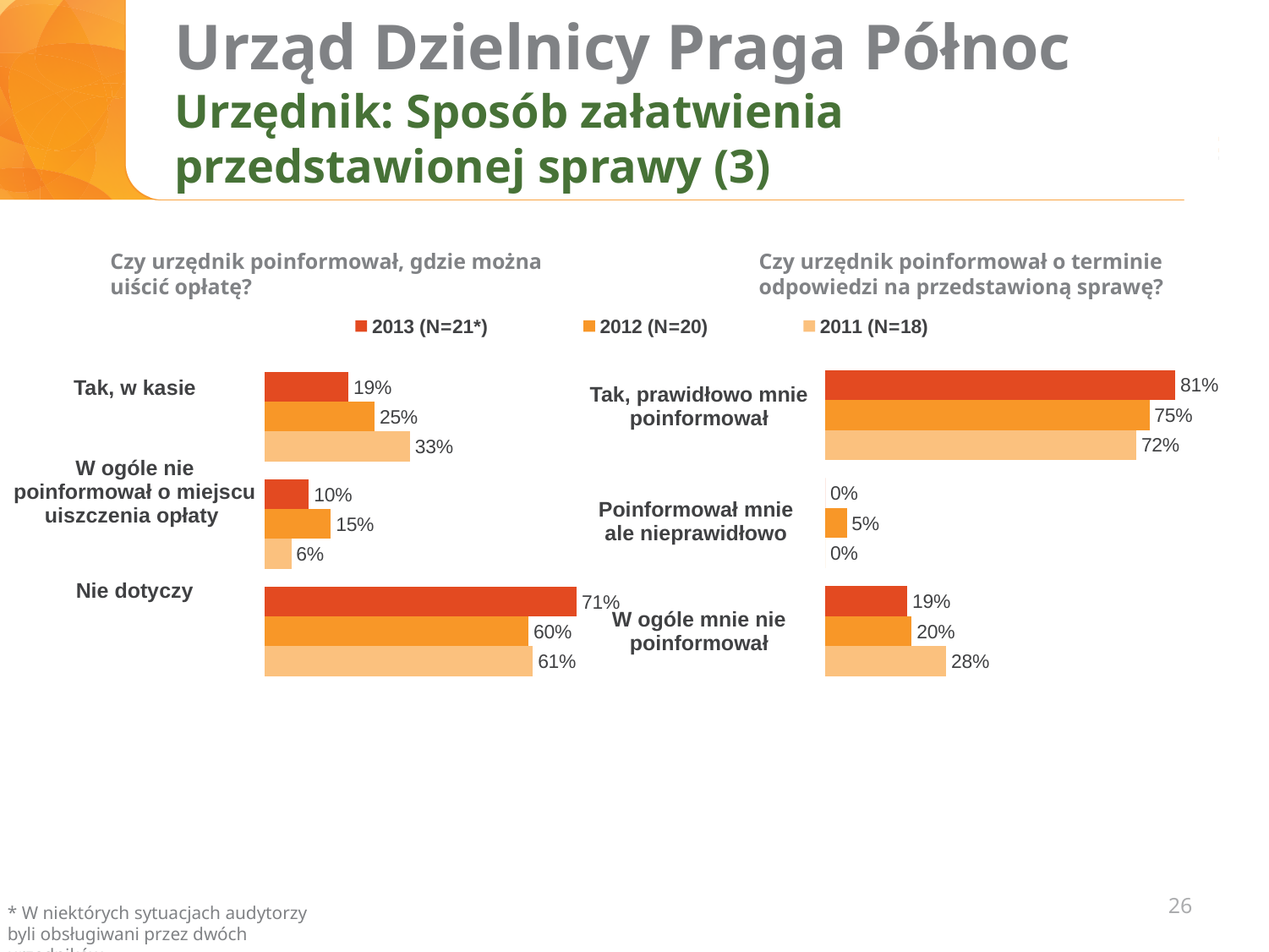
In the right chart ("Czy urzędnik poinformował o terminie odpowiedzi na przedstawioną sprawę?"), what is the value for "Poinformował mnie ale nieprawidłowo" in 2012 (N=20)? 5% What kind of chart is the left chart ("Czy urzędnik poinformował, gdzie można uiścić opłatę?")? Bar chart In the right chart ("Czy urzędnik poinformował o terminie odpowiedzi na przedstawioną sprawę?"), which category has the lowest value for 2011 (N=18)? Poinformował mnie ale nieprawidłowo In the right chart ("Czy urzędnik poinformował o terminie odpowiedzi na przedstawioną sprawę?"), what is the value for "Tak, prawidłowo mnie poinformował" in 2011 (N=18)? 72% How many categories are shown in the right chart ("Czy urzędnik poinformował o terminie odpowiedzi na przedstawioną sprawę?")? 3 In the left chart ("Czy urzędnik poinformował, gdzie można uiścić opłatę?"), which is larger for "Tak, w kasie": the 2012 (N=20) value or the 2011 (N=18) value? 2011 (N=18) In the left chart ("Czy urzędnik poinformował, gdzie można uiścić opłatę?"), what is the value for "Tak, w kasie" in 2013 (N=21*)? 19% In the left chart ("Czy urzędnik poinformował, gdzie można uiścić opłatę?"), which category has the highest value for 2013 (N=21*)? Nie dotyczy In the left chart ("Czy urzędnik poinformował, gdzie można uiścić opłatę?"), what is the difference between the 2012 (N=20) and 2011 (N=18) values for "W ogóle nie poinformował o miejscu uiszczenia opłaty"? 9 percentage points In the left chart ("Czy urzędnik poinformował, gdzie można uiścić opłatę?"), what is the value for "Nie dotyczy" in 2012 (N=20)? 60% In the right chart ("Czy urzędnik poinformował o terminie odpowiedzi na przedstawioną sprawę?"), what is the difference between the 2013 (N=21*) and 2011 (N=18) values for "Tak, prawidłowo mnie poinformował"? 9 percentage points How many series does the legend list? 3